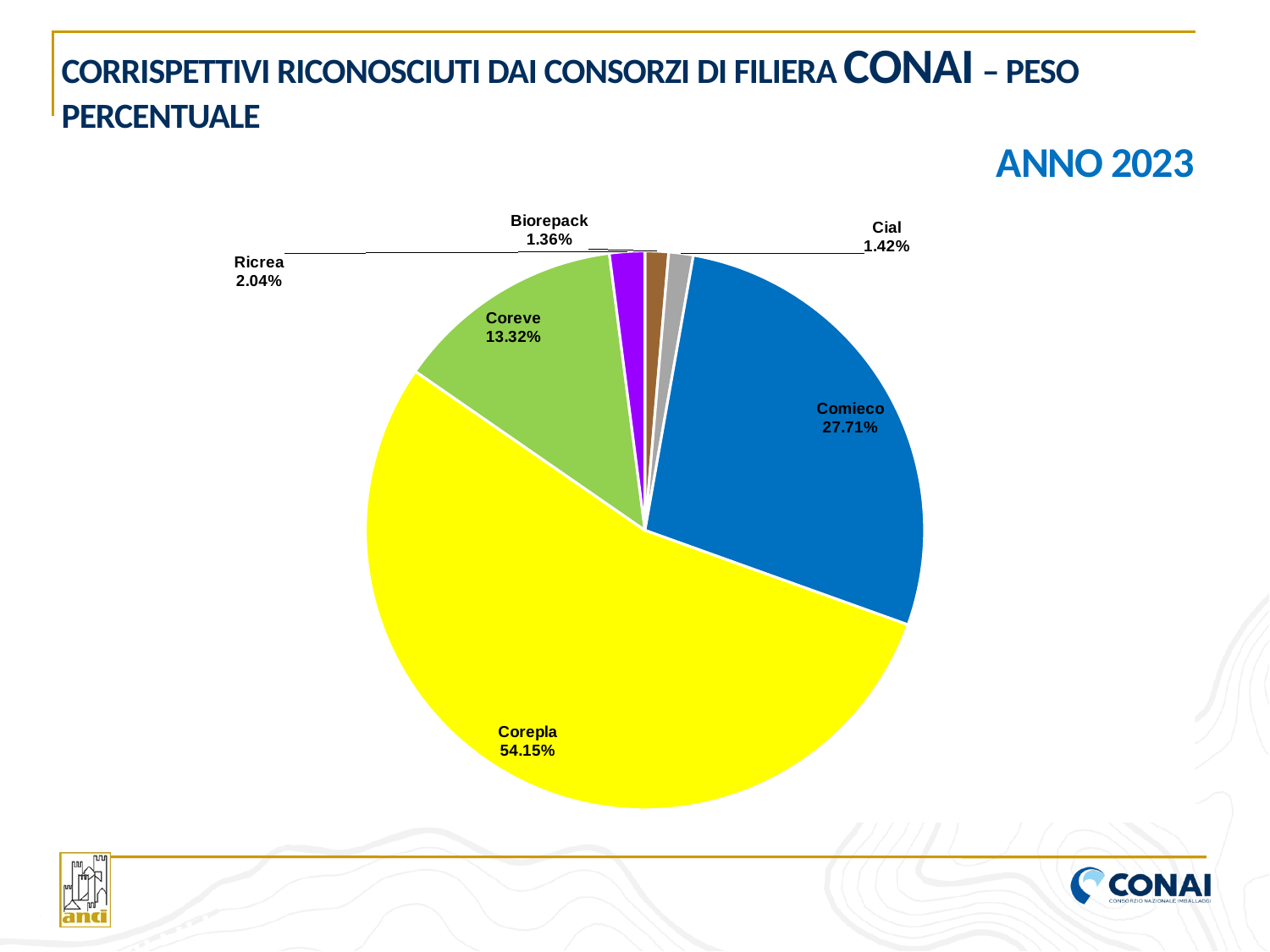
How many slices does the pie chart have? 6 What is the value shown for Ricrea? 2.04% What percentage is shown for Biorepack? 1.36% What percentage is shown for Coreve? 13.32% What percentage share does Corepla have in the pie chart? 54.15% Which consortium has the smallest slice of the pie? Biorepack What type of chart is shown on the slide? Pie chart Which has a larger share, Coreve or Comieco? Comieco Which consortium has the largest slice of the pie? Corepla What is the value shown for Comieco? 27.71% Which year does the chart refer to? 2023 What is the difference in percentage points between Corepla and Comieco? 26.44